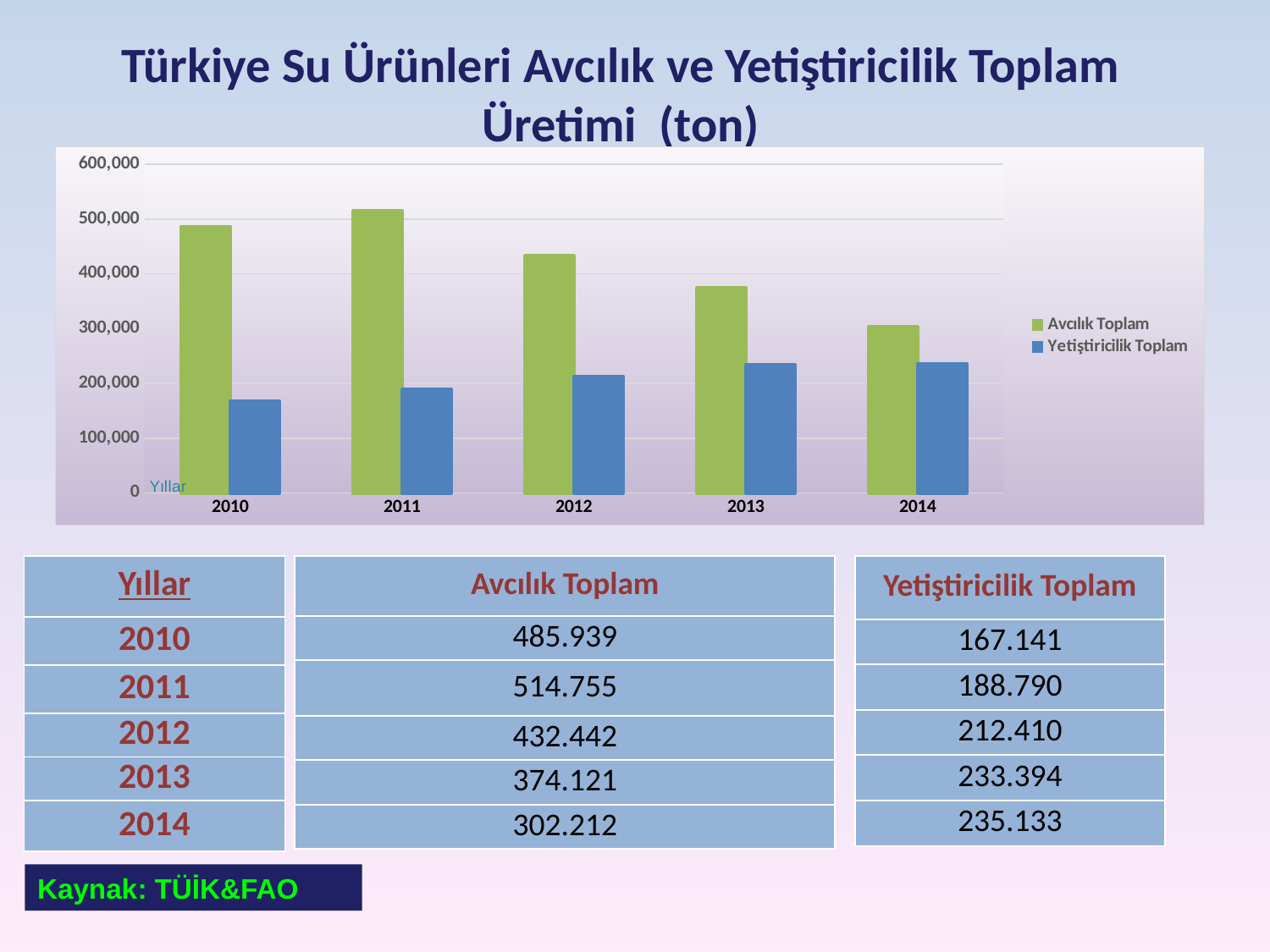
What is the Avcılık Toplam value for 2011? 514.755 What is the difference between Avcılık Toplam and Yetiştiricilik Toplam in 2011? 325.965 Does Yetiştiricilik Toplam rise or fall from 2010 to 2014? rise In which year is Avcılık Toplam highest? 2011 What is the Yetiştiricilik Toplam value for 2014? 235.133 Is the Avcılık Toplam value for 2010 greater or less than 400,000? greater In which year is Avcılık Toplam lowest? 2014 In which year is Yetiştiricilik Toplam lowest? 2010 How many years are shown on the x axis of the chart? 5 Which is larger in 2013, Avcılık Toplam or Yetiştiricilik Toplam? Avcılık Toplam What kind of chart is shown on the slide? bar chart How many series does the chart legend list? 2